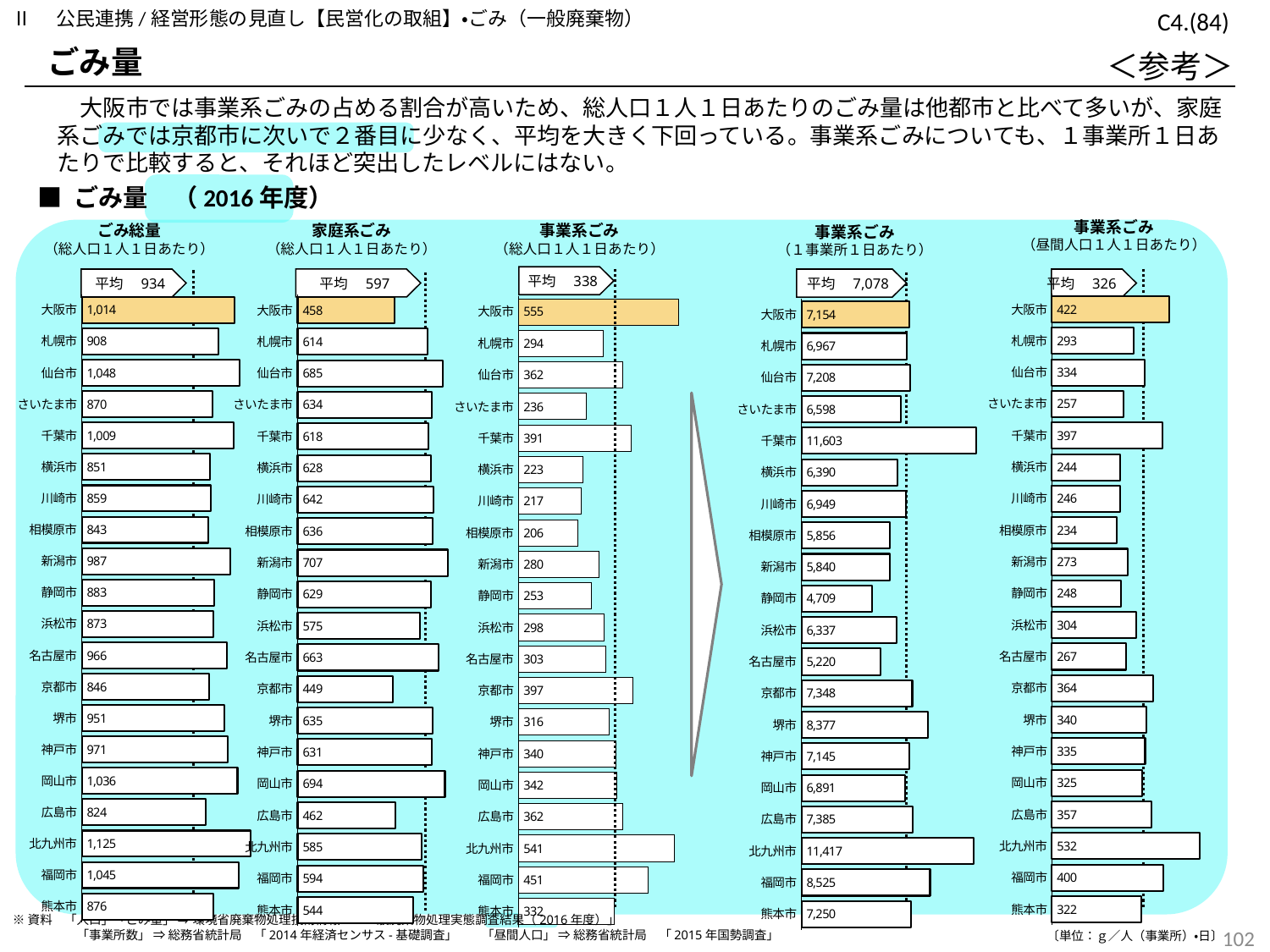
In the 事業系ごみ（総人口1人1日あたり） chart, which is larger, the value for 大阪市 or the value for 北九州市? 大阪市 In the ごみ総量（総人口1人1日あたり） chart, which city has the highest value? 北九州市 In the 家庭系ごみ（総人口1人1日あたり） chart, what is the difference between the values for 大阪市 and 京都市? 9 In the 事業系ごみ（1事業所1日あたり） chart, what is the difference between the values for 千葉市 and 北九州市? 186 In the 事業系ごみ（1事業所1日あたり） chart, what is the value for 福岡市? 8,525 In the 家庭系ごみ（総人口1人1日あたり） chart, what is the value for 京都市? 449 In the 家庭系ごみ（総人口1人1日あたり） chart, which city has the lowest value? 京都市 How many cities are shown in the ごみ総量（総人口1人1日あたり） chart? 20 In the 事業系ごみ（昼間人口1人1日あたり） chart, which city has the lowest value? 相模原市 What kind of chart is the 事業系ごみ（昼間人口1人1日あたり） chart? bar chart In the ごみ総量（総人口1人1日あたり） chart, what is the value for 大阪市? 1,014 In the 事業系ごみ（1事業所1日あたり） chart, which city has the highest value? 千葉市